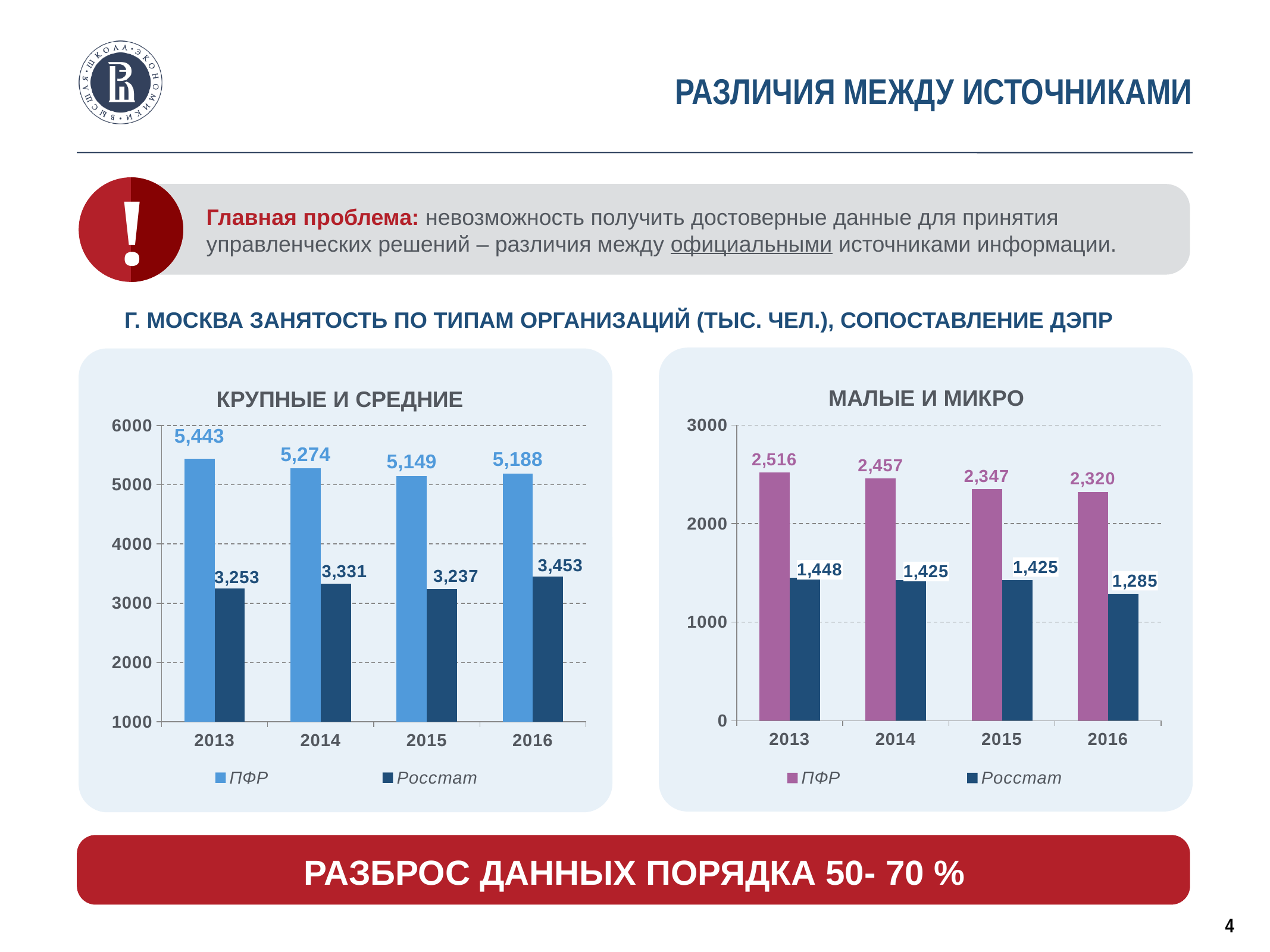
How many years are shown on the x axis of the 'КРУПНЫЕ И СРЕДНИЕ' chart? 4 In the 'МАЛЫЕ И МИКРО' chart, what is the difference between the ПФР and Росстат values for 2016? 1,035 In the 'КРУПНЫЕ И СРЕДНИЕ' chart, what is the ПФР value for 2013? 5,443 In the 'МАЛЫЕ И МИКРО' chart, do the ПФР values rise or fall from 2013 to 2016? Fall In the 'КРУПНЫЕ И СРЕДНИЕ' chart, which year has the highest Росстат value? 2016 In the 'КРУПНЫЕ И СРЕДНИЕ' chart, which is larger for 2015: the ПФР value or the Росстат value? ПФР In the 'МАЛЫЕ И МИКРО' chart, is the ПФР value for 2014 greater or less than 2000? greater How many series does the legend of the 'МАЛЫЕ И МИКРО' chart list? 2 In the 'МАЛЫЕ И МИКРО' chart, which year has the lowest ПФР value? 2016 In the 'КРУПНЫЕ И СРЕДНИЕ' chart, what is the difference between the ПФР and Росстат values for 2013? 2,190 In the 'МАЛЫЕ И МИКРО' chart, what is the Росстат value for 2016? 1,285 What kind of chart is the 'МАЛЫЕ И МИКРО' chart? Bar chart